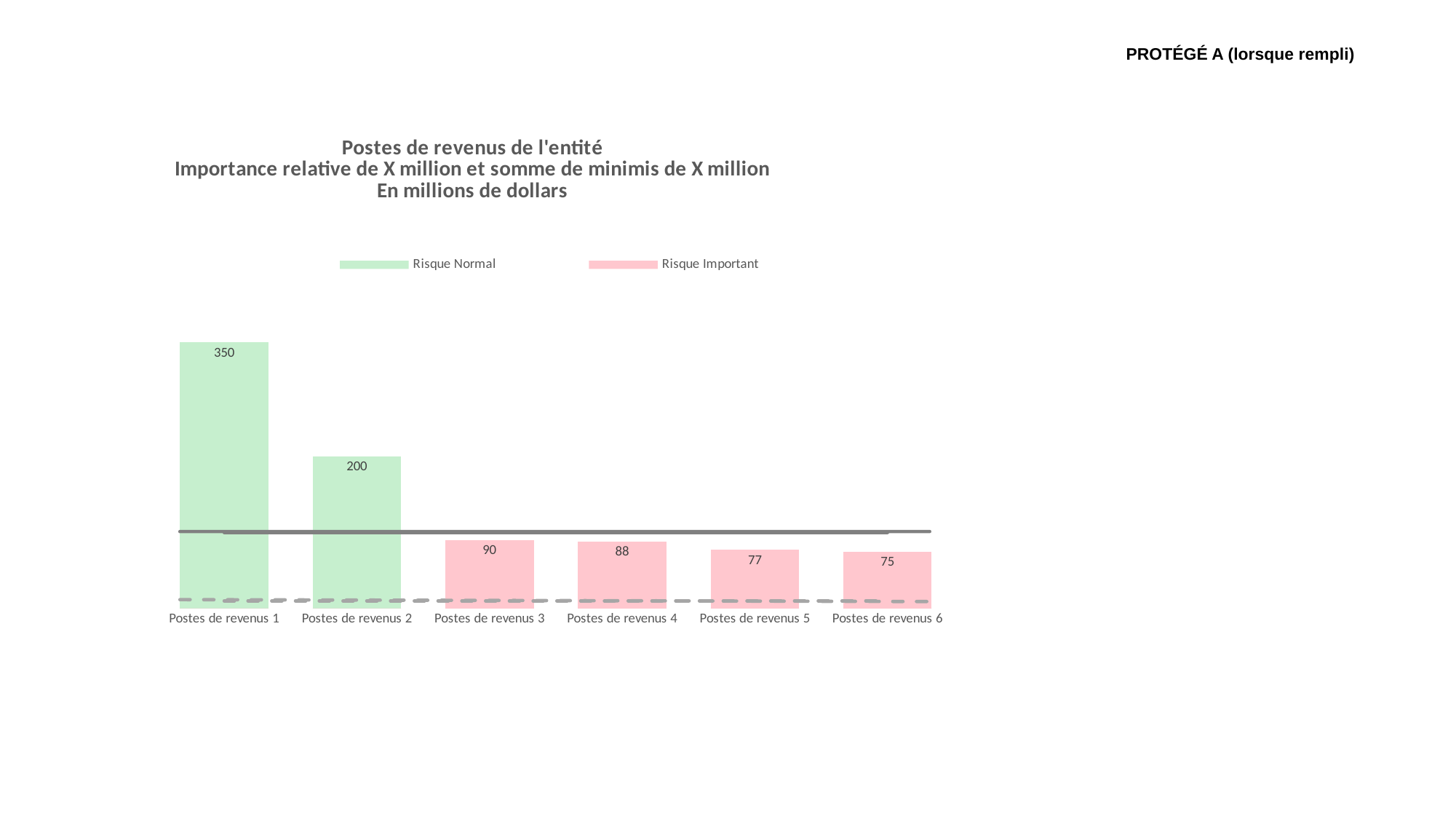
How many series does the legend list? 2 What is the difference between the values for Postes de revenus 1 and Postes de revenus 2? 150 What is the value for Postes de revenus 6? 75 How many categories are shown on the x axis? 6 What is the difference between the values for Postes de revenus 3 and Postes de revenus 5? 13 Which category has the lowest value? Postes de revenus 6 Which category has the highest value? Postes de revenus 1 What is the value for Postes de revenus 1? 350 Which is larger, the value for Postes de revenus 2 or Postes de revenus 3? Postes de revenus 2 What kind of chart is shown? combination bar and line chart Do the values rise or fall from Postes de revenus 1 to Postes de revenus 6? fall What is the value for Postes de revenus 4? 88